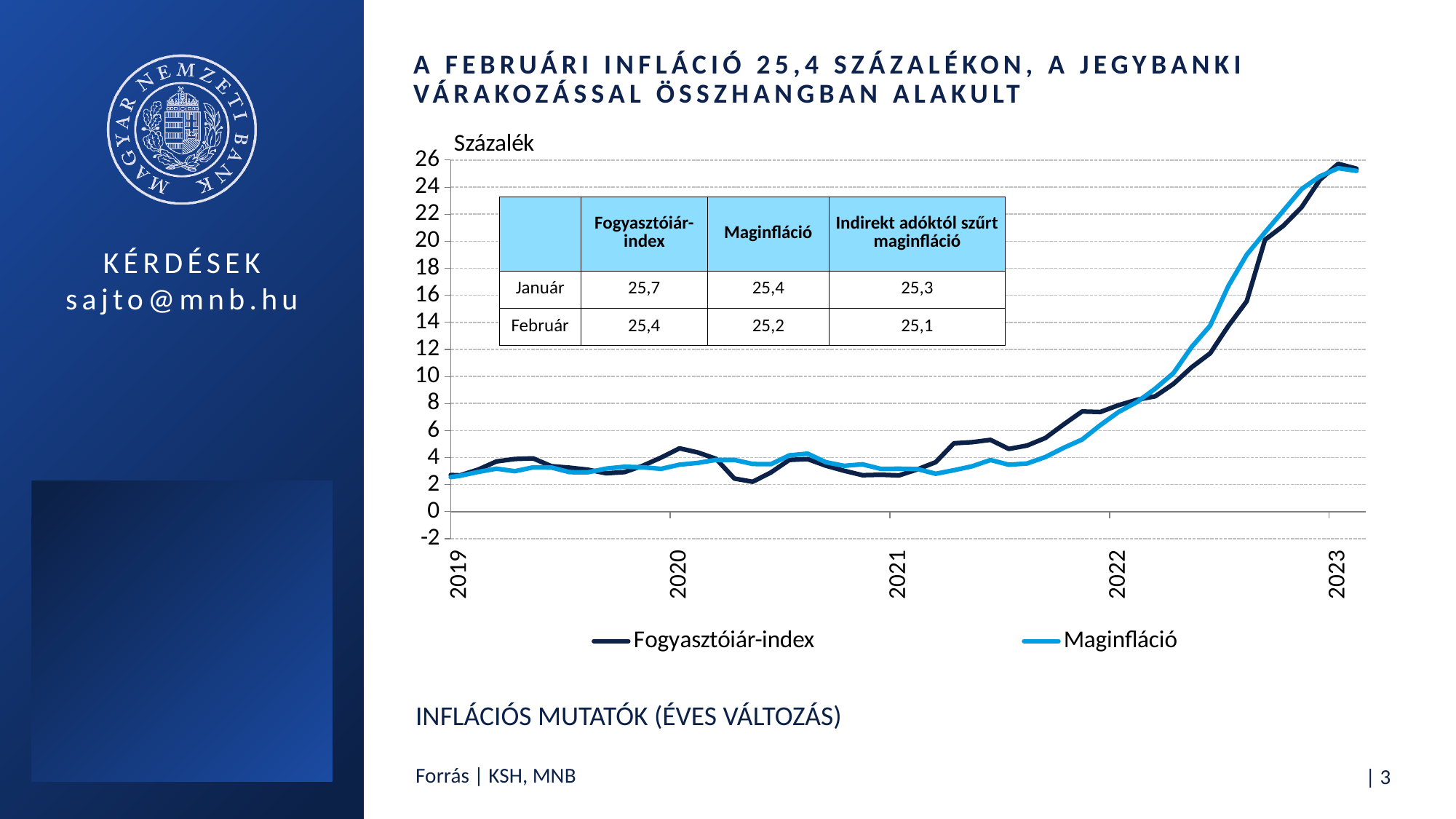
How many series does the chart legend list? 2 In Január, which is larger according to the table: Fogyasztóiár-index or Maginfláció? Fogyasztóiár-index According to the table in the chart, what is the Fogyasztóiár-index value for Február? 25,4 What unit label is shown at the top of the y axis? Százalék What is the title of the chart shown below the plot? Inflációs mutatók (éves változás) According to the table in the chart, what is the Indirekt adóktól szűrt maginfláció value for Február? 25,1 According to the table in the chart, what is the Maginfláció value for Január? 25,4 What kind of chart is shown on the slide? line chart Is the Maginfláció value at the 2021 tick greater or less than 6? less Is the Fogyasztóiár-index value at the 2023 tick greater or less than 24? greater By how much did the Fogyasztóiár-index fall from Január to Február according to the table? 0,3 Do the plotted values rise or fall between the 2022 and 2023 ticks on the x axis? rise